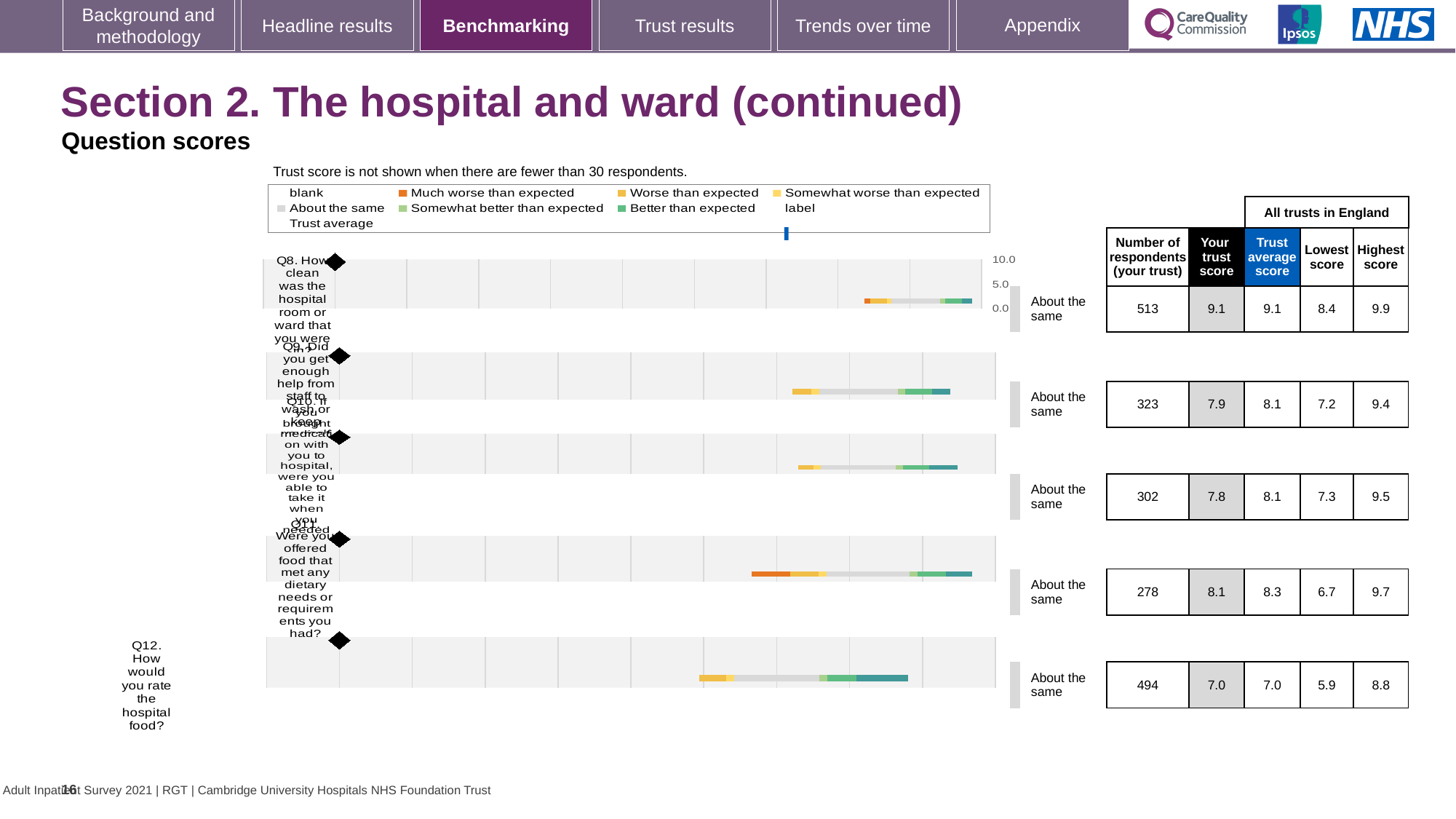
What is the trust average score for Q10 (medication brought with you to hospital)? 8.1 What is the difference between the highest score and the lowest score for Q8? 1.5 What is the number of respondents for Q12 (how would you rate the hospital food)? 494 Which question has the highest 'Your trust score'? Q8 Which question has the lowest 'Your trust score'? Q12 What is the lowest score across all trusts in England for Q11 (offered food that met dietary needs)? 6.7 What kind of chart is used to show the question scores on this slide? bar chart What is the trust score for Q8 (how clean was the hospital room or ward)? 9.1 What benchmark category is shown for Q12 (how would you rate the hospital food)? About the same Which legend entry is shown in the darkest orange colour? Much worse than expected Which has more respondents, Q9 or Q10? Q9 How many questions (Q8 to Q12) are plotted in the chart? 5